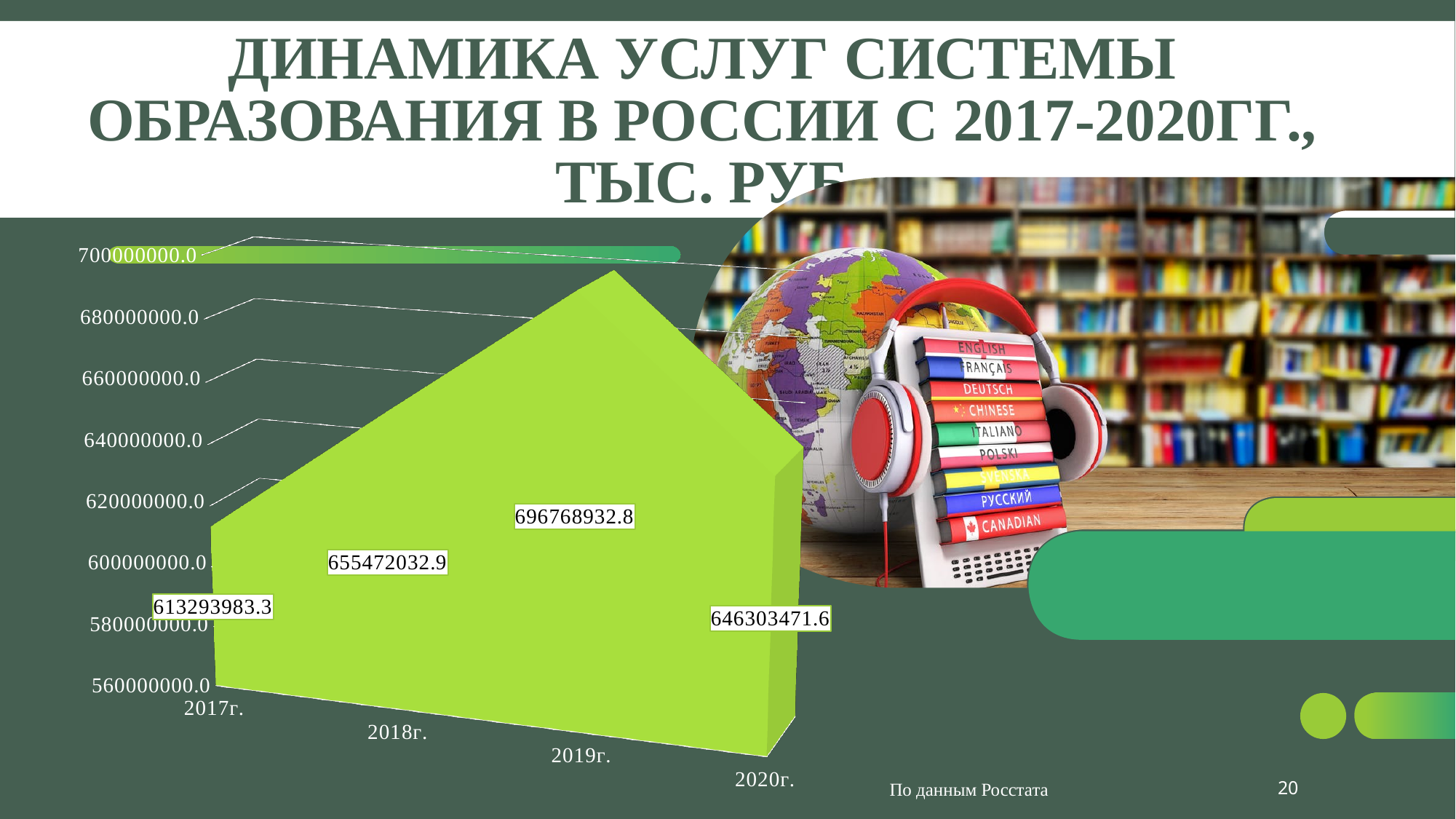
What is the difference between the values for 2019г. and 2018г.? 41296899.9 What is the value for 2017г.? 613293983.3 What kind of chart is shown on the slide? area chart What is the value for 2018г.? 655472032.9 Which year has the lowest value? 2017г. What is the value for 2020г.? 646303471.6 Which year has the highest value? 2019г. What is the difference between the values for 2019г. and 2020г.? 50465461.2 What is the value for 2019г.? 696768932.8 How do the values change from 2017г. to 2020г.? They rise from 2017 to 2019, then fall in 2020 How many years are plotted on the chart? 4 Which is larger, the value for 2018г. or the value for 2020г.? 2018г.